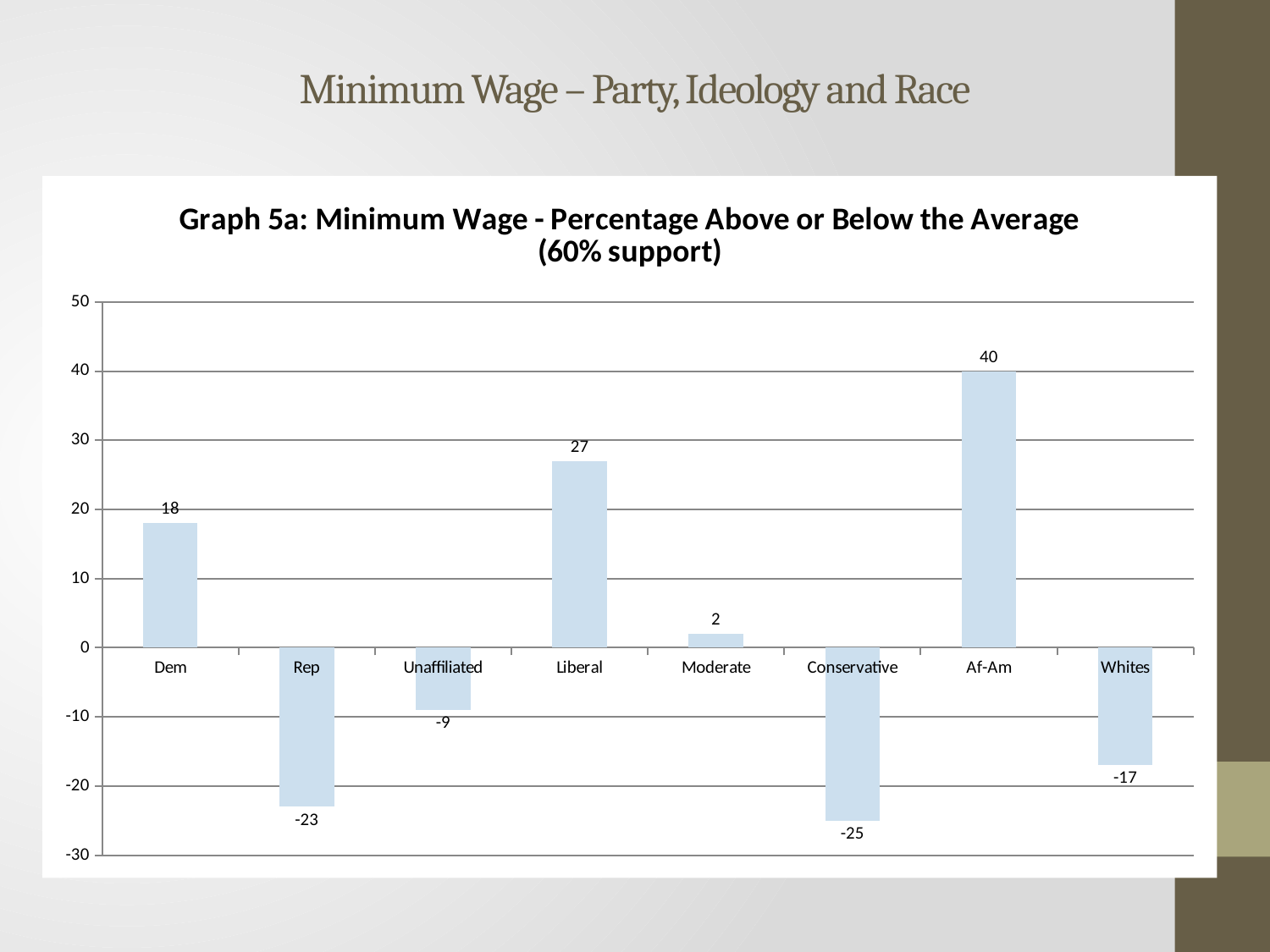
What is the value for Rep? -23 How many categories are shown on the x axis? 8 Which is larger, the value for Dem or the value for Liberal? Liberal Which category has the lowest value? Conservative What is the value for Unaffiliated? -9 What kind of chart is shown on the slide? Bar chart What is the value for Af-Am? 40 What is the title of the chart? Graph 5a: Minimum Wage - Percentage Above or Below the Average (60% support) Which category has the highest value? Af-Am What is the difference between the values for Af-Am and Liberal? 13 What is the difference between the values for Dem and Rep? 41 What is the value for Moderate? 2